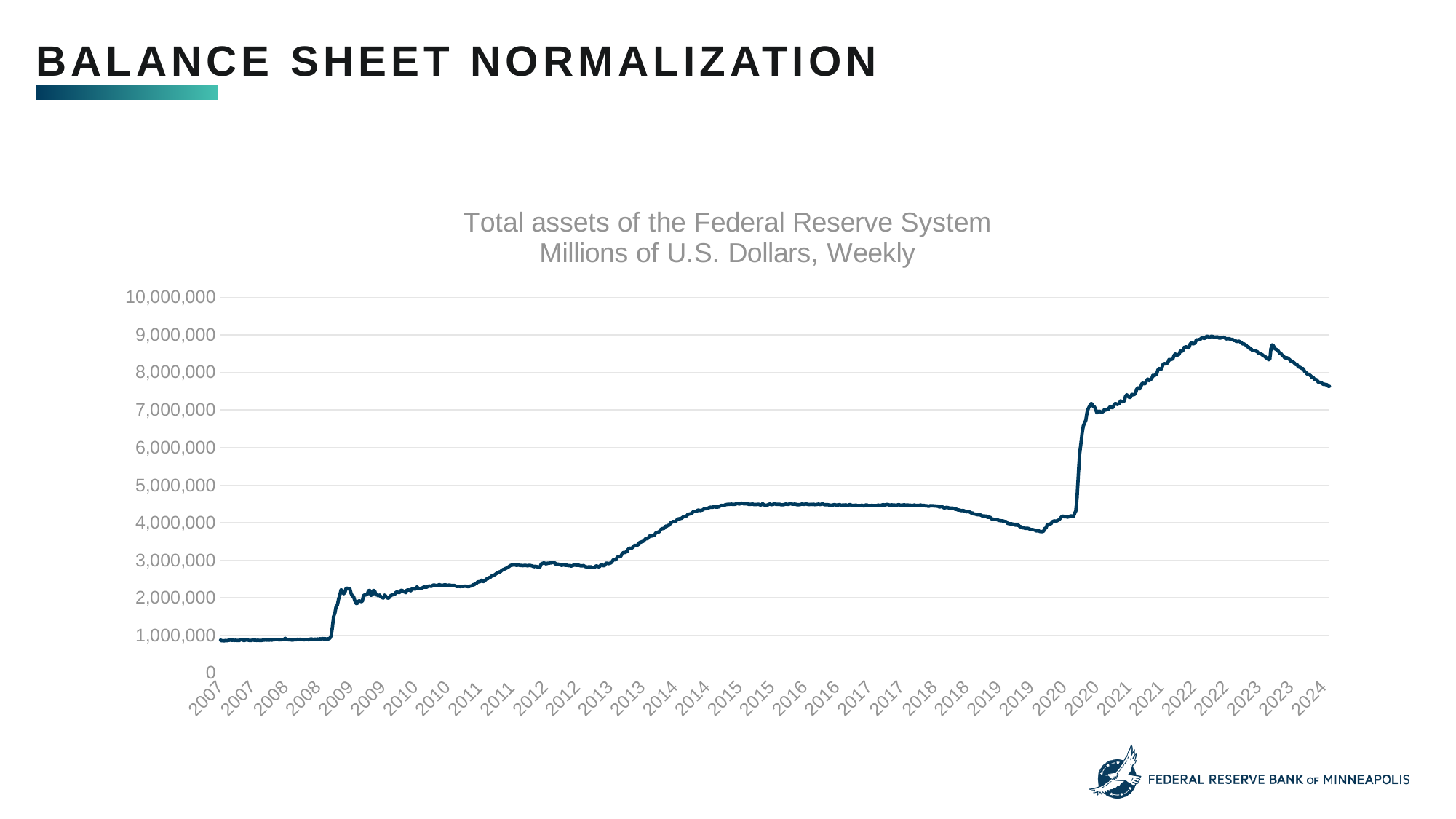
In which year is the line at its lowest value? 2007 In which year does the line reach its highest value? 2022 Is the peak value in 2022 greater or less than 8,000,000? greater Is the value in 2010 greater or less than 3,000,000? less Is the value at the end of the series in 2024 greater or less than 7,000,000? greater Is the value in 2022 larger or smaller than the value in 2015? larger What kind of chart is shown on the slide? line chart Does the line rise or fall from its 2022 peak to 2024? fall In what units and frequency are the chart's values reported, according to the subtitle? Millions of U.S. Dollars, Weekly What is the title of the chart? Total assets of the Federal Reserve System